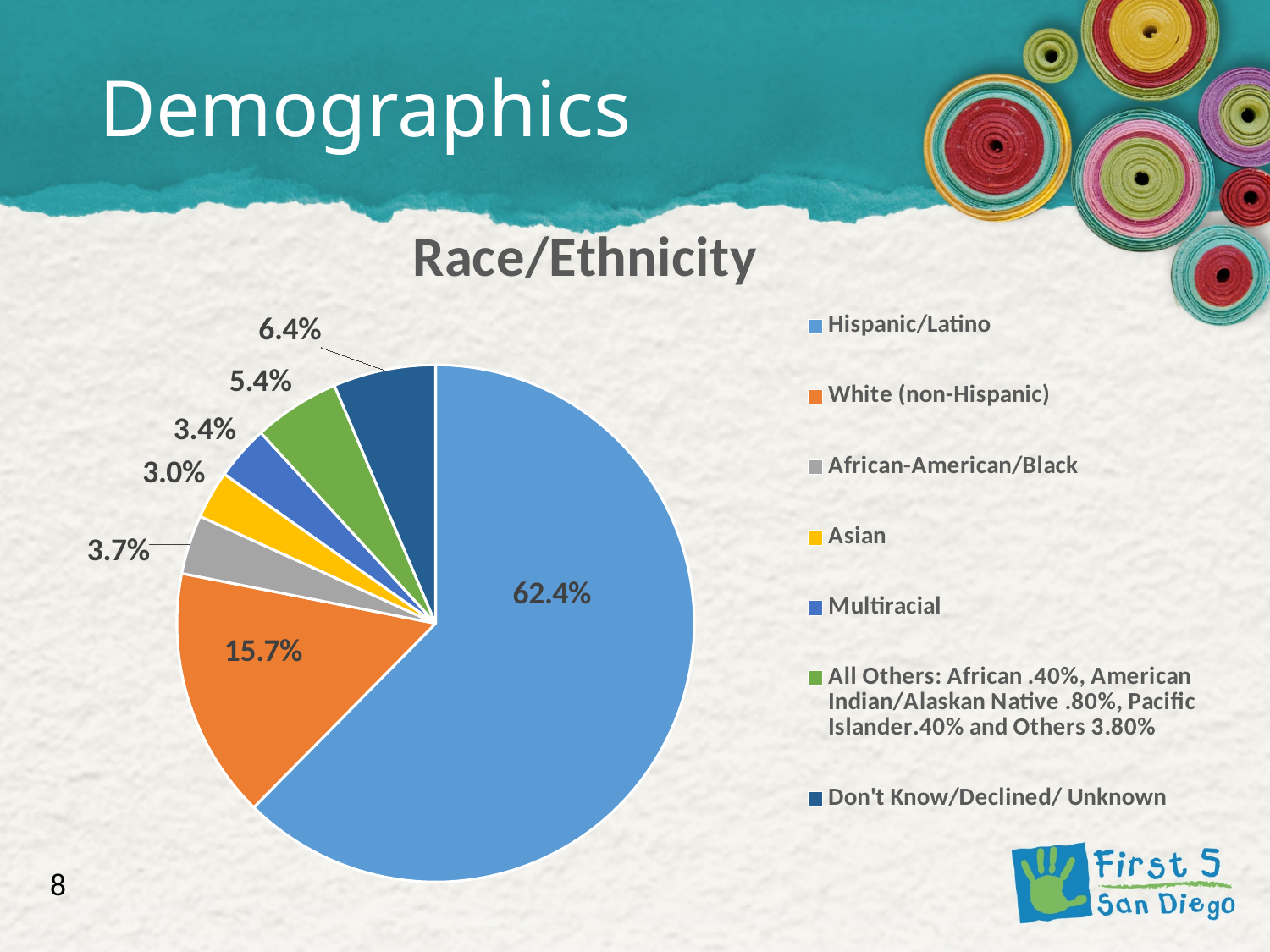
What percentage of the pie is Don't Know/Declined/ Unknown? 6.4% What percentage of the pie is African-American/Black? 3.7% What percentage of the pie is Hispanic/Latino? 62.4% What is the difference between the Hispanic/Latino share and the White (non-Hispanic) share? 46.7% Which is larger, the Multiracial share or the All Others share? All Others What percentage of the pie is White (non-Hispanic)? 15.7% Which category has the largest share of the pie? Hispanic/Latino What type of chart is shown on the slide? Pie chart What is the title of the chart? Race/Ethnicity How many categories does the legend list? 7 Which category has the smallest share of the pie? Asian What percentage of the pie is Asian? 3.0%